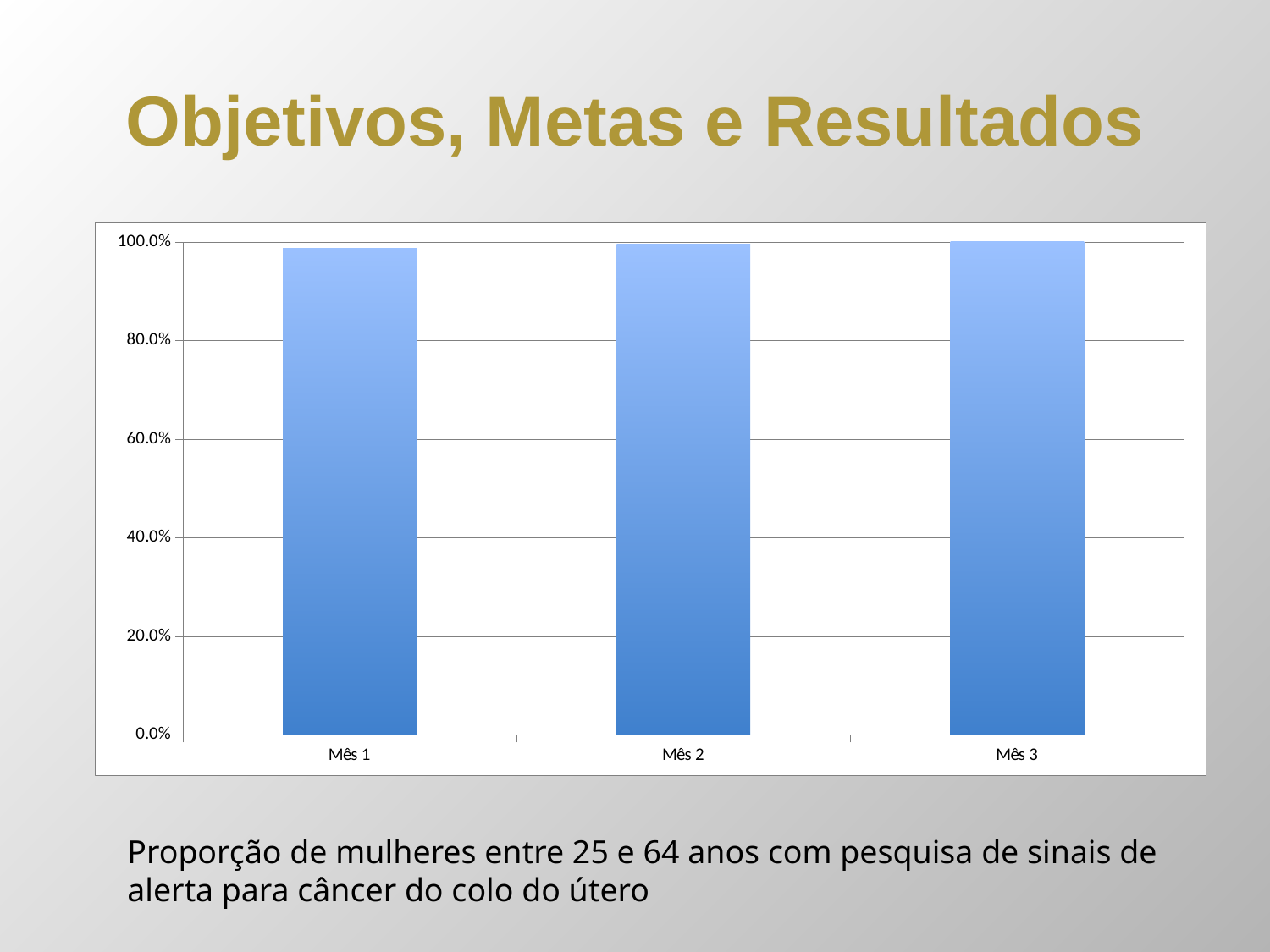
What is the label of the first category on the x axis? Mês 1 How many categories are plotted on the chart? 3 Is the value for Mês 3 greater or less than 80.0%? greater What is the highest value shown on the y axis? 100.0% What is the value for Mês 3? 100.0% What kind of chart is shown on the slide? bar chart Is the value for Mês 1 greater or less than 80.0%? greater Is the value for Mês 2 greater or less than 60.0%? greater